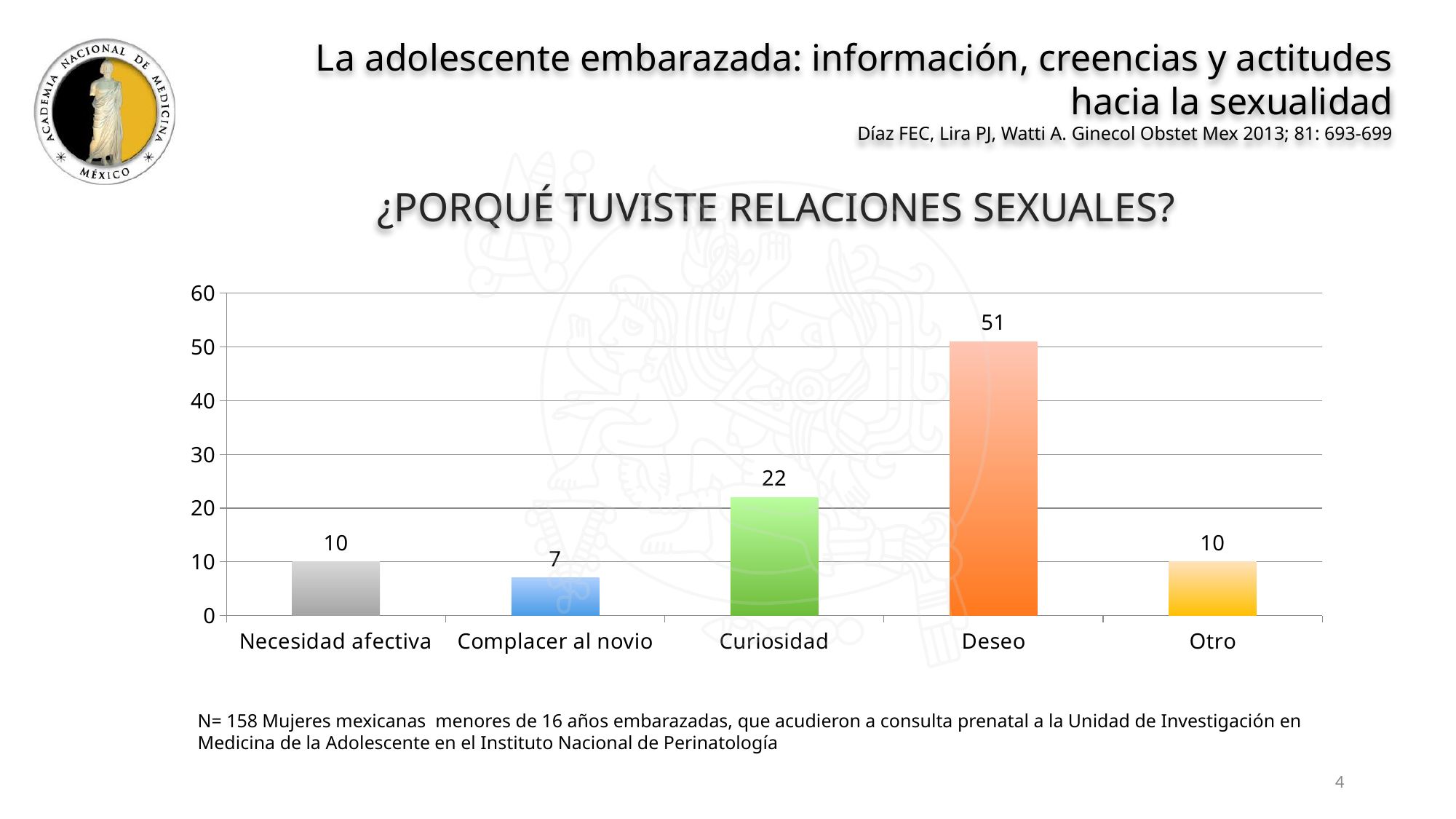
How many categories are shown on the x axis? 5 What is the difference between the values for Otro and Complacer al novio? 3 Which category has the highest value? Deseo What is the difference between the values for Deseo and Curiosidad? 29 Is the value for Deseo greater or less than 40? greater What kind of chart is shown on the slide? Bar chart What is the value for Deseo? 51 Which category has the lowest value? Complacer al novio Which is larger, the value for Curiosidad or the value for Necesidad afectiva? Curiosidad What is the value for Complacer al novio? 7 What is the value for Necesidad afectiva? 10 What is the value for Curiosidad? 22